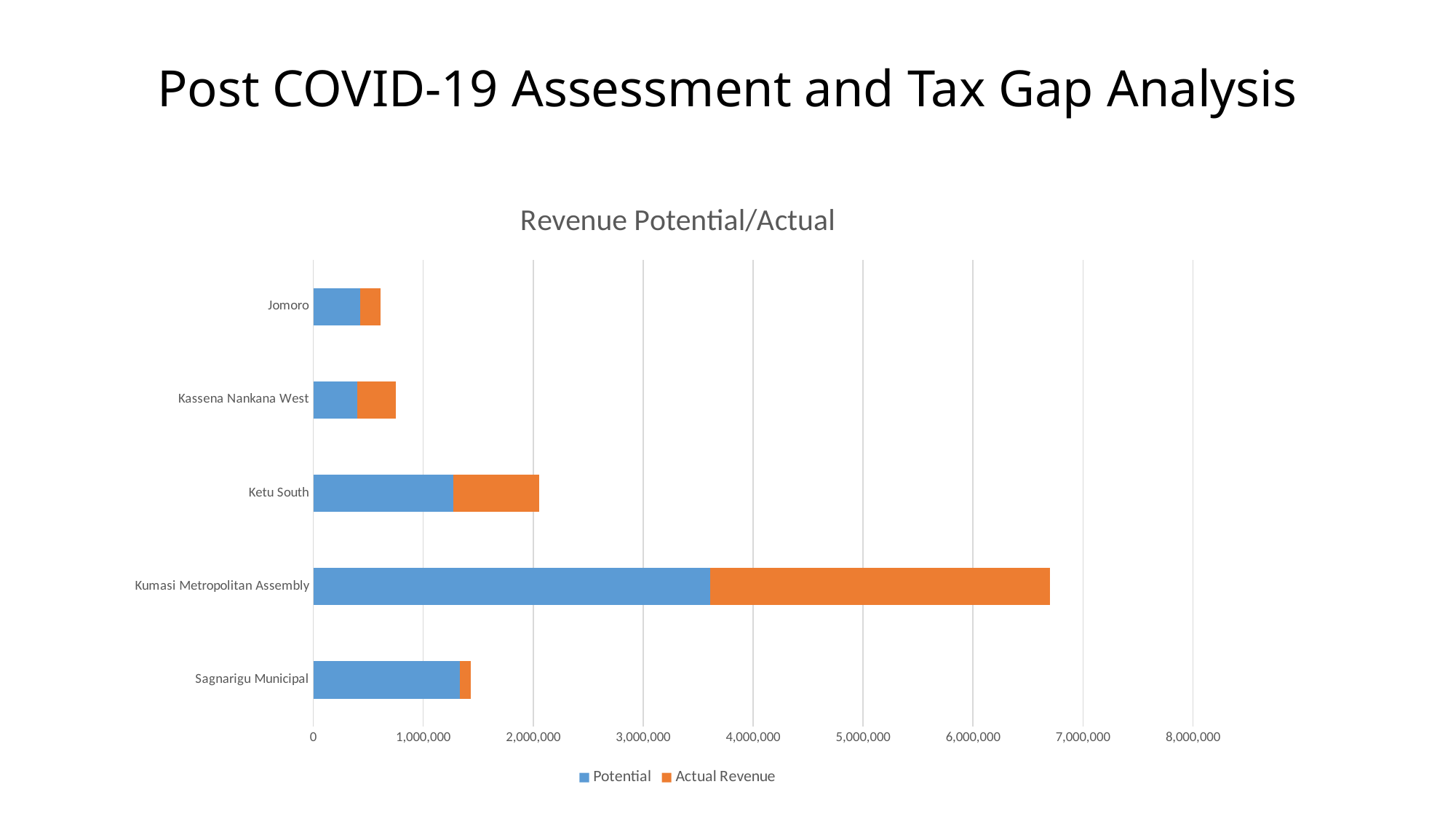
Is the total bar for Kumasi Metropolitan Assembly greater or less than 6,000,000? greater Is the Potential value for Ketu South greater or less than 1,000,000? greater How many categories (assemblies) are plotted on the chart? 5 Which colour represents Actual Revenue in the chart? Orange Is the total bar for Sagnarigu Municipal greater or less than 2,000,000? less What kind of chart is shown on the slide? Stacked bar chart How many series does the legend list? 2 What is the title of the chart? Revenue Potential/Actual Which category has the shortest total bar? Jomoro Which has the larger Actual Revenue segment, Ketu South or Kumasi Metropolitan Assembly? Kumasi Metropolitan Assembly Which category has the longest total bar? Kumasi Metropolitan Assembly